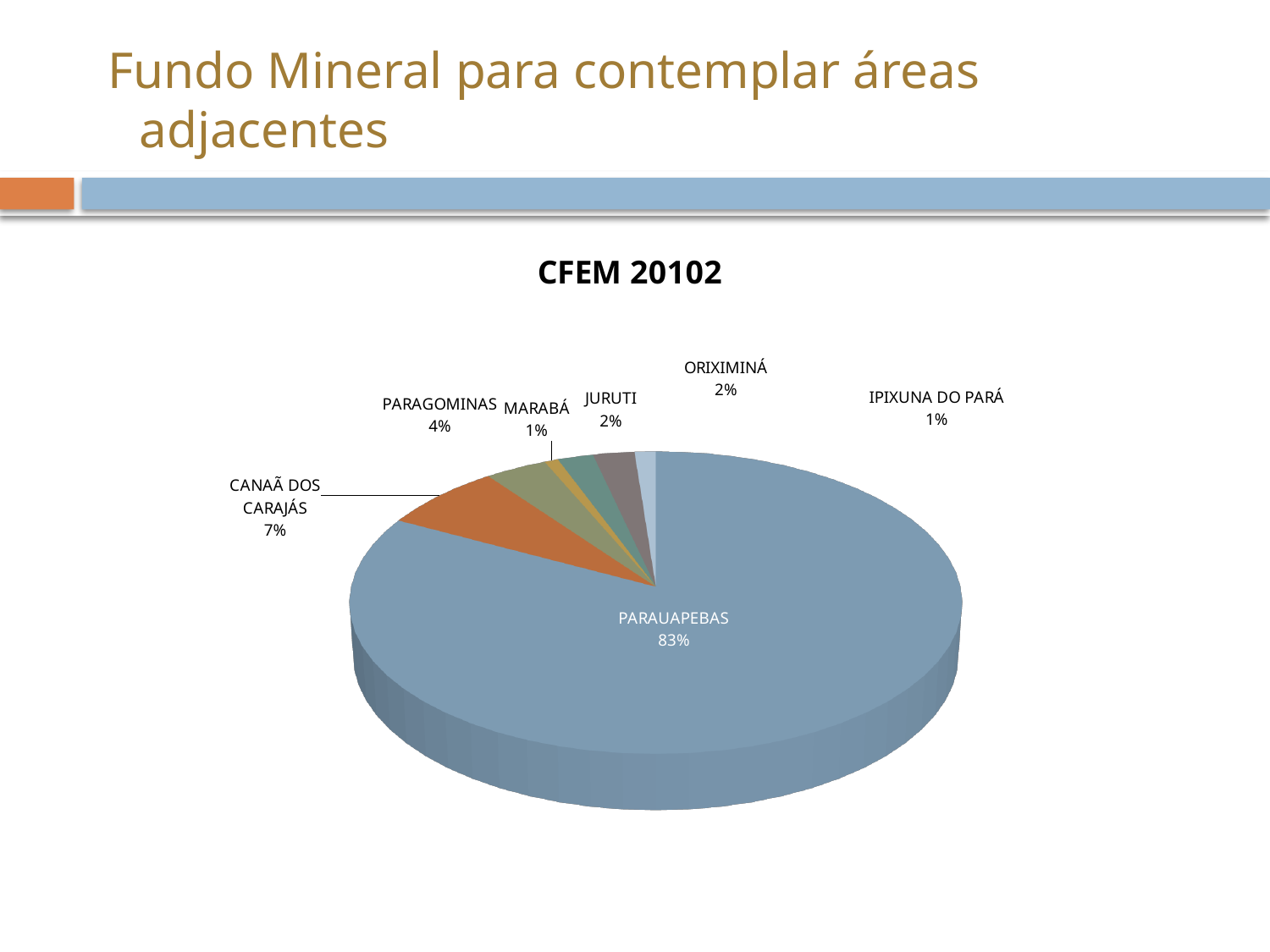
How many categories (slices) are shown in the pie chart? 7 What is the value shown for JURUTI? 2% What is the title of the chart? CFEM 20102 What type of chart is shown on the slide? Pie chart What is the value shown for IPIXUNA DO PARÁ? 1% What is the difference in percentage points between CANAÃ DOS CARAJÁS and PARAGOMINAS? 3 percentage points Which category has the largest slice of the pie? PARAUAPEBAS Which is larger, the share for PARAGOMINAS or the share for MARABÁ? PARAGOMINAS What share of the pie does CANAÃ DOS CARAJÁS hold? 7% What share of the pie does PARAUAPEBAS hold? 83% What is the difference in percentage points between PARAUAPEBAS and CANAÃ DOS CARAJÁS? 76 percentage points What is the value shown for PARAGOMINAS? 4%